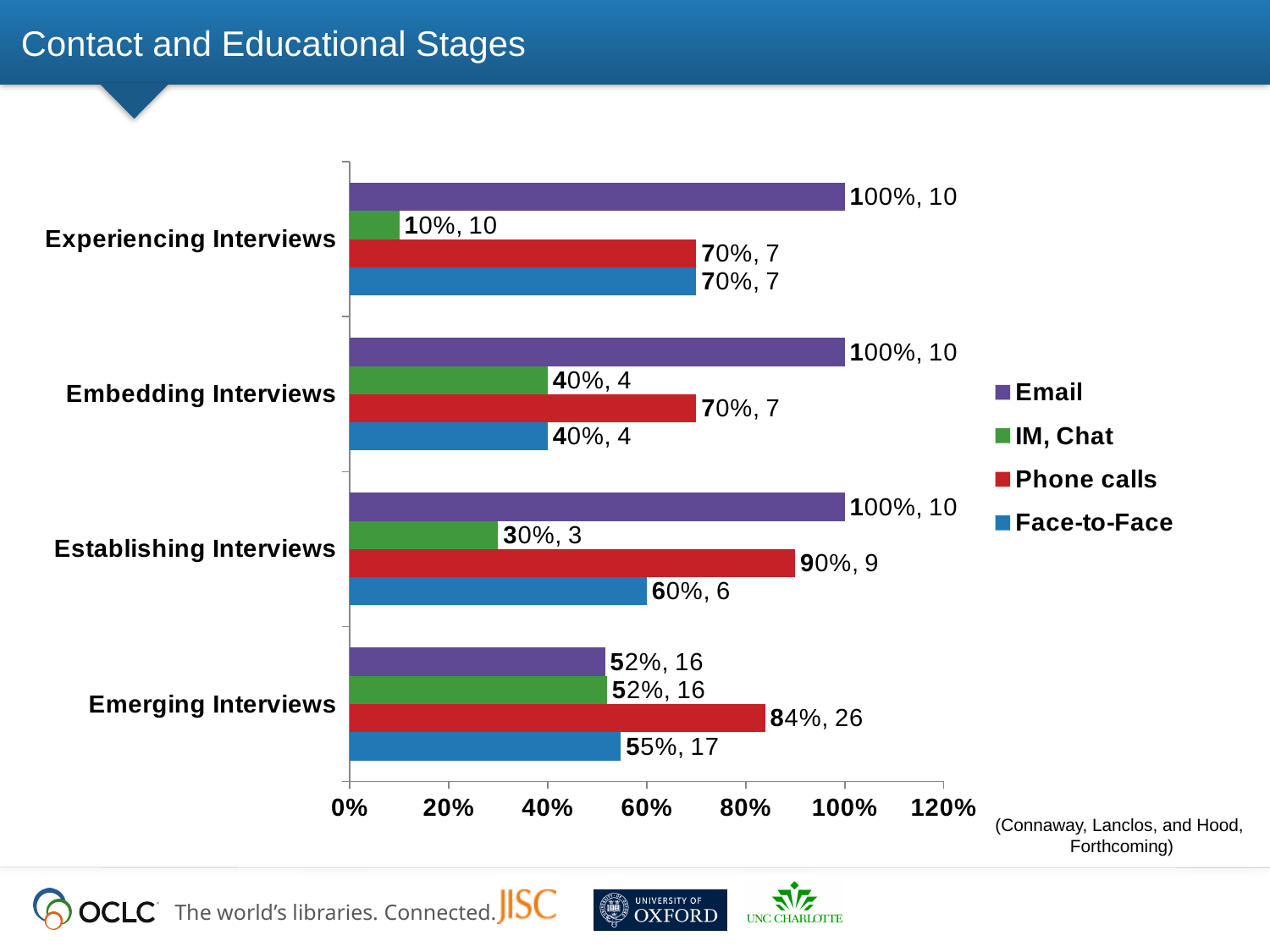
How many interview stage categories are plotted on the chart? 4 What is the difference in percentage between Phone calls and Face-to-Face in the Establishing Interviews category? 30% What is the data label for IM, Chat in the Experiencing Interviews category? 10%, 10 Which series has the highest percentage in the Emerging Interviews category? Phone calls What kind of chart is shown on the slide? bar chart What is the data label for Phone calls in the Emerging Interviews category? 84%, 26 In the Embedding Interviews category, which is larger: the percentage for Phone calls or for IM, Chat? Phone calls How many series does the legend list? 4 What is the data label for Face-to-Face in the Establishing Interviews category? 60%, 6 What is the data label for Email in the Experiencing Interviews category? 100%, 10 Which series has the lowest percentage in the Establishing Interviews category? IM, Chat Which legend entry is shown in purple? Email